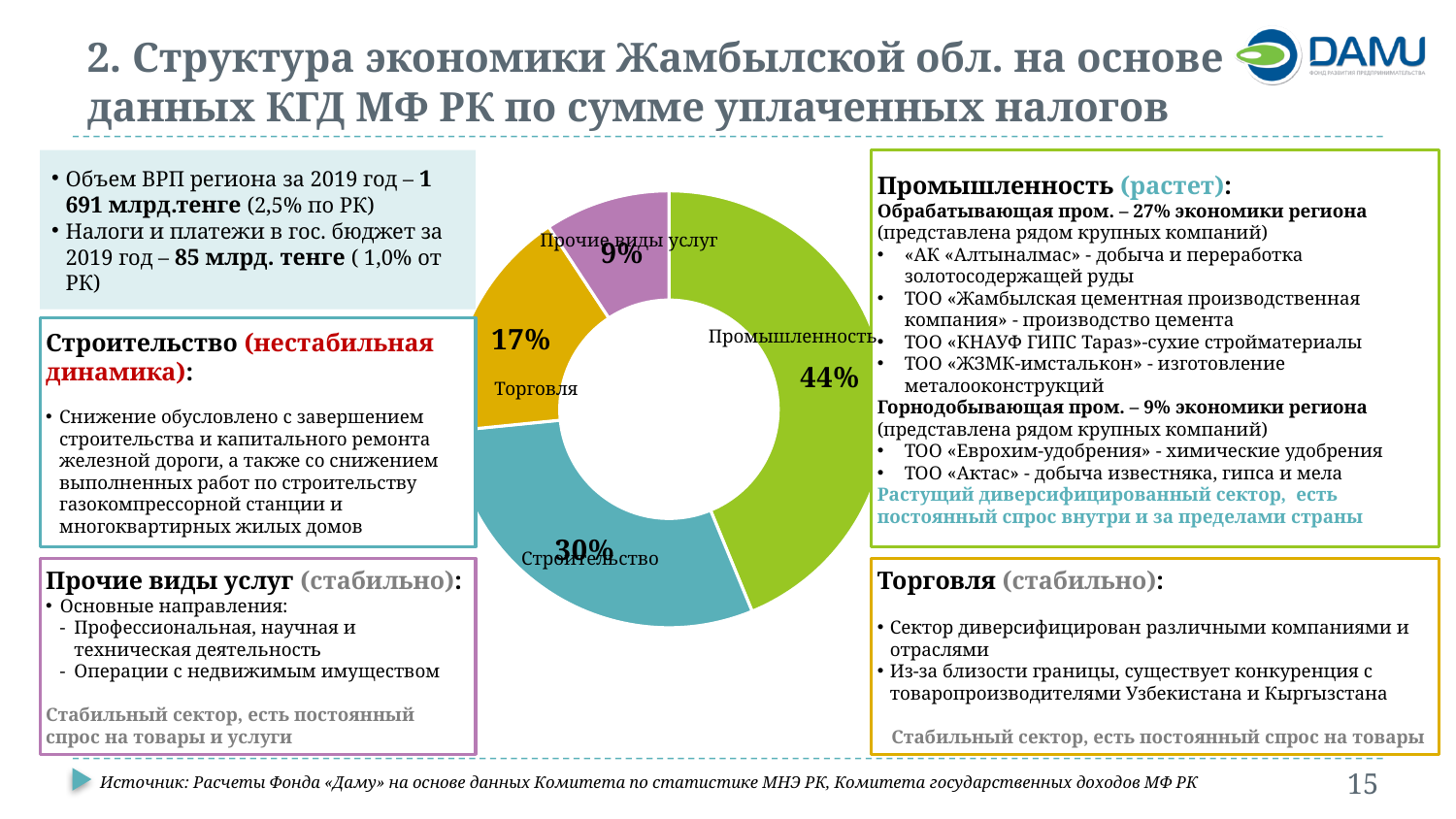
What is the difference in percentage points between Промышленность and Строительство? 14 Which sector has the smallest share in the chart? Прочие виды услуг What colour is the Строительство slice in the chart? Teal (blue-green) Which is larger in the chart, Торговля or Прочие виды услуг? Торговля What share of the economy does Промышленность have in the chart? 44% What kind of chart is shown on the slide? Donut (pie) chart What is the combined share of Торговля and Прочие виды услуг? 26% What share does Прочие виды услуг have in the chart? 9% What share does Строительство have in the chart? 30% Which sector has the largest share in the chart? Промышленность What share does Торговля have in the chart? 17% How many sectors are shown in the chart? 4